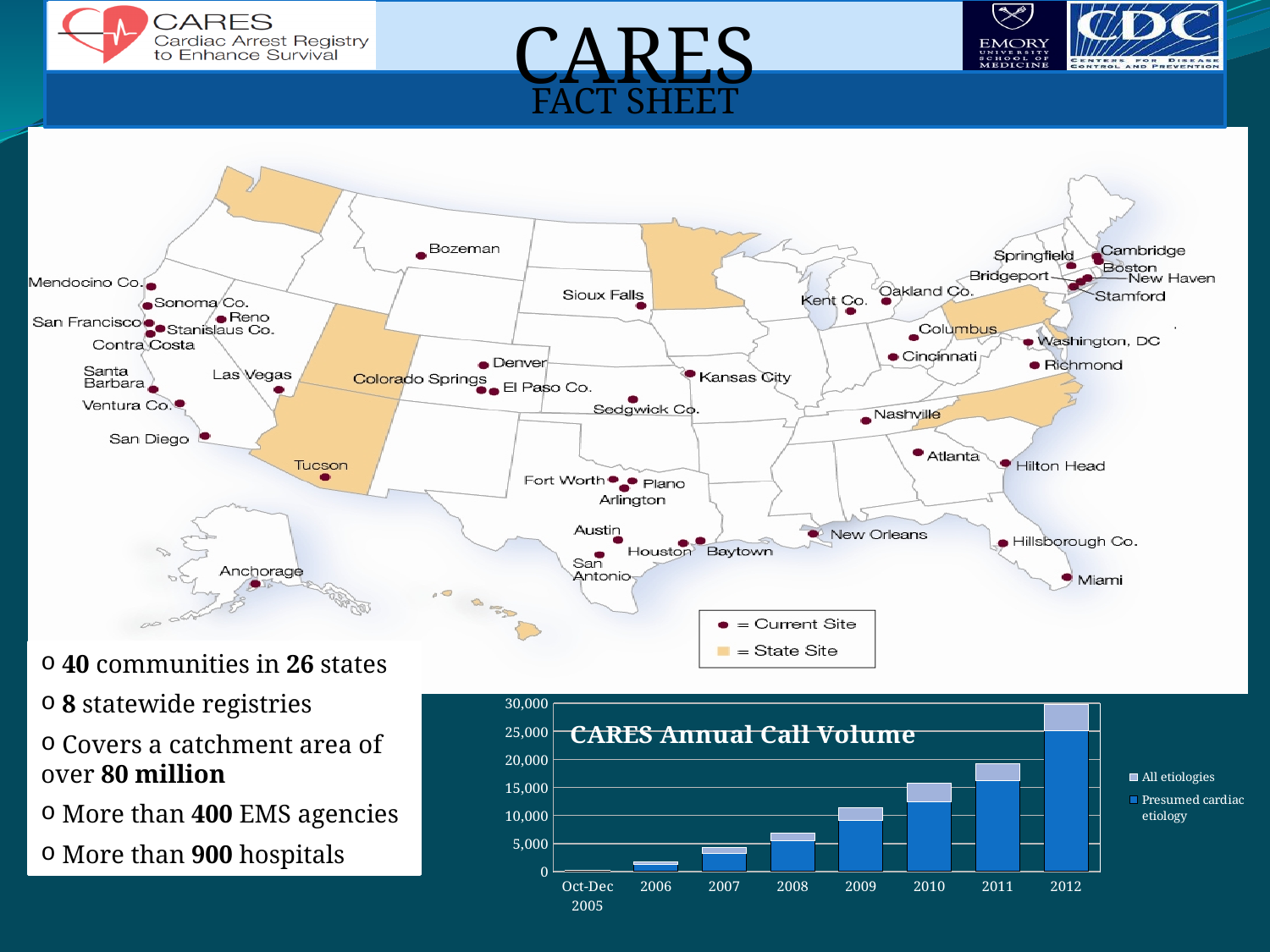
What type of chart is the CARES Annual Call Volume chart? bar chart In the CARES Annual Call Volume chart, is the total call volume for 2011 greater or less than 15,000? greater What is the title of the chart at the bottom of the slide? CARES Annual Call Volume In the CARES Annual Call Volume chart, which period has the lowest total call volume? Oct-Dec 2005 In the CARES Annual Call Volume chart, which period has the highest total call volume? 2012 How many series does the legend of the CARES Annual Call Volume chart list? 2 How many time periods are shown on the x axis of the CARES Annual Call Volume chart? 8 In the CARES Annual Call Volume chart, which has the larger total call volume, 2010 or 2011? 2011 In the CARES Annual Call Volume chart, which legend entry is shown in the darker blue colour? Presumed cardiac etiology In the CARES Annual Call Volume chart, is the presumed cardiac etiology value for 2012 greater or less than 20,000? greater In the CARES Annual Call Volume chart, is the total call volume for 2008 greater or less than 10,000? less In the CARES Annual Call Volume chart, do the call volumes rise or fall from Oct-Dec 2005 to 2012? rise